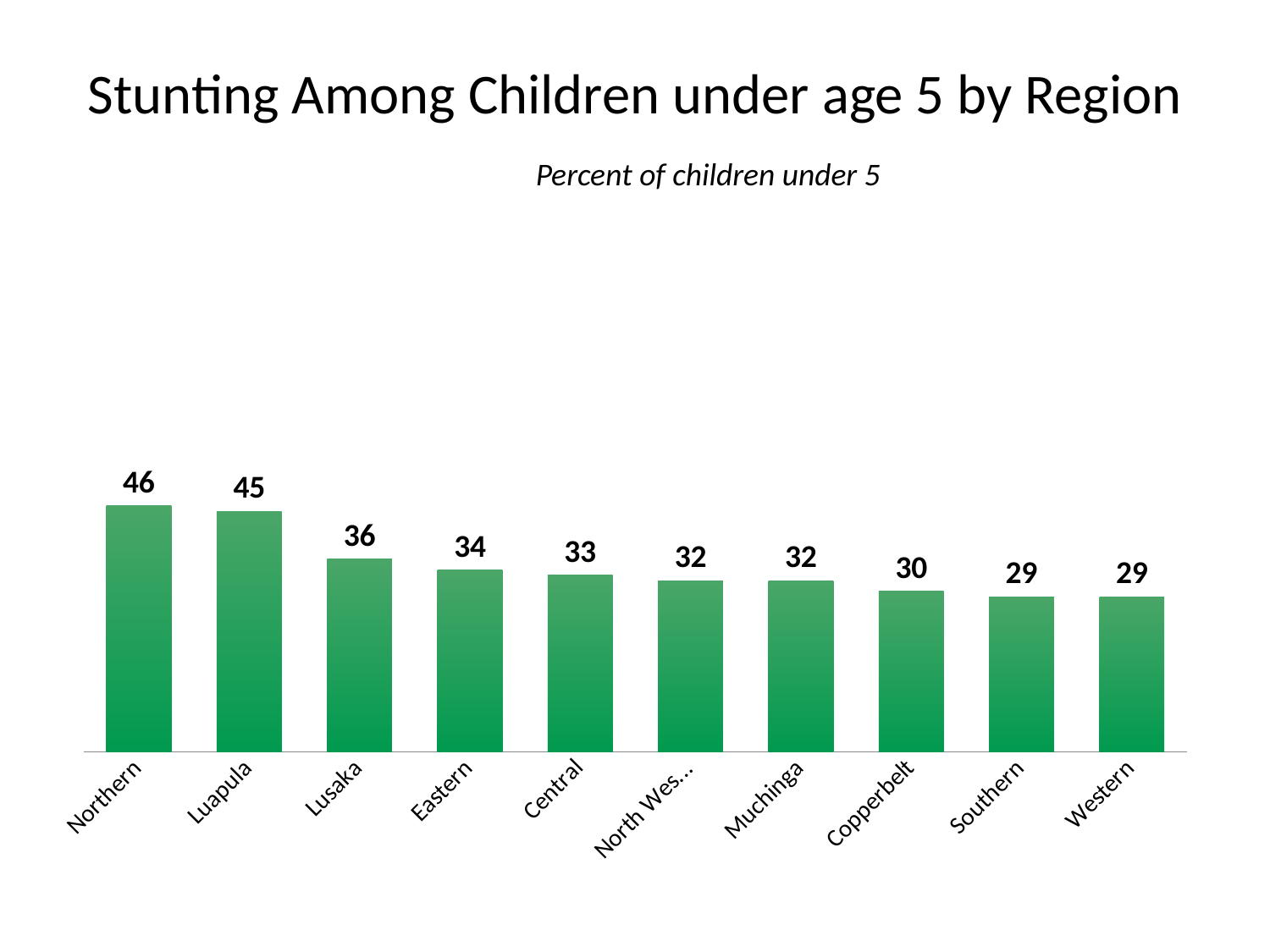
What is the value shown for Copperbelt? 30 How many regions are shown in the chart? 10 Which region has the highest stunting percentage? Northern What kind of chart is shown on the slide? Bar chart What is the value shown for Eastern? 34 What is the difference between the values for Northern and Luapula? 1 Which is larger, the value for Central or the value for Muchinga? Central What is the difference between the values for Lusaka and Western? 7 What is the value shown for Lusaka? 36 Do the values rise or fall from left to right across the chart? Fall What is the title of the chart? Stunting Among Children under age 5 by Region What is the stunting percentage for Northern region? 46